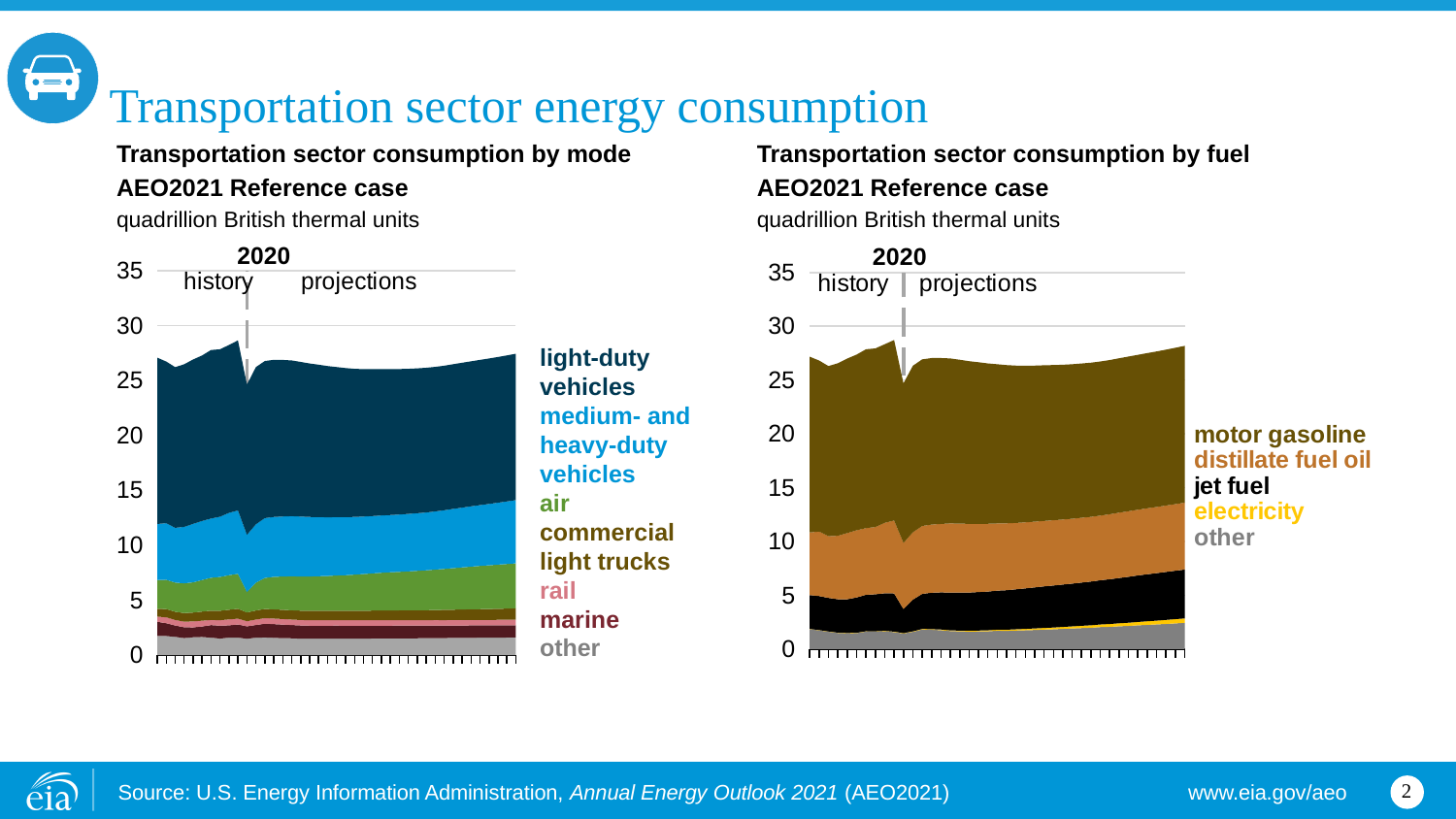
What kind of chart is the 'Transportation sector consumption by mode' chart on the left? stacked area chart In the 'Transportation sector consumption by fuel' chart, which fuel accounts for the largest share of consumption? motor gasoline How many series does the legend of the 'Transportation sector consumption by mode' chart list? 7 In the 'Transportation sector consumption by fuel' chart, is the electricity band at the end of the projection period greater or less than 5? less In the 'Transportation sector consumption by fuel' chart, is the total consumption at the end of the projection period greater or less than 25? greater In the 'Transportation sector consumption by mode' chart, which is larger: light-duty vehicles or rail? light-duty vehicles In the 'Transportation sector consumption by fuel' chart, which is larger: motor gasoline or jet fuel? motor gasoline How many series does the legend of the 'Transportation sector consumption by fuel' chart list? 5 In the 'Transportation sector consumption by mode' chart, which mode accounts for the largest share of consumption? light-duty vehicles What unit is used on the y axis of both charts? quadrillion British thermal units In the 'Transportation sector consumption by fuel' chart, is the total consumption at the end of the projection period greater or less than 30? less Which year separates history from projections in both charts? 2020